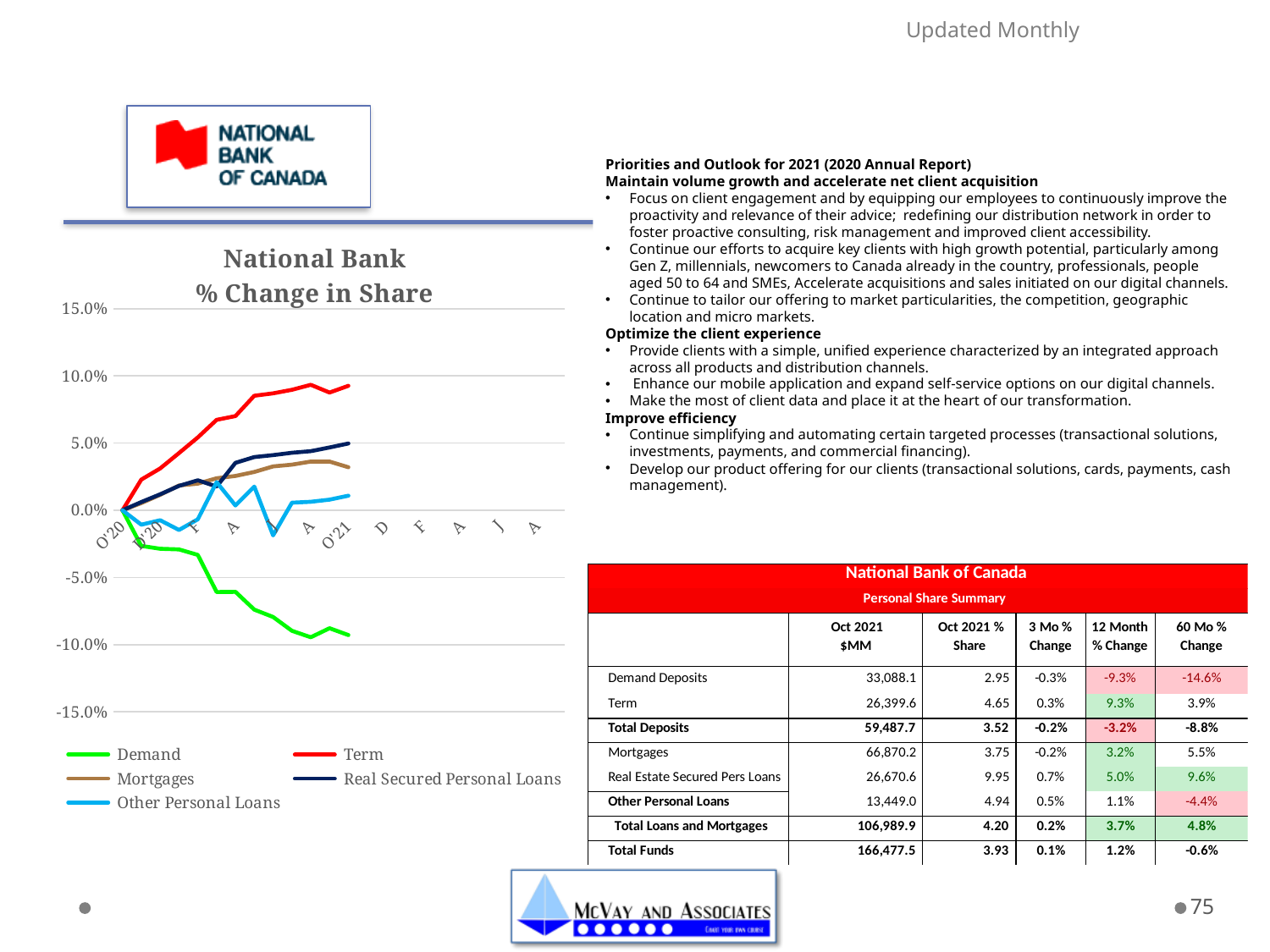
How many series does the legend of the 'National Bank % Change in Share' chart list? 5 In the 'National Bank % Change in Share' chart, is the value for Term at O'21 greater or less than 5.0%? greater What is the title of the line chart on the slide? National Bank % Change in Share In the 'National Bank % Change in Share' chart, is the value for Mortgages at O'21 greater or less than 5.0%? less In the 'National Bank % Change in Share' chart, what colour is the Demand line? green In the 'National Bank % Change in Share' chart, is the value for Demand at O'21 greater or less than -5.0%? less In the 'National Bank % Change in Share' chart, which series has the highest value at the end of the plotted period (O'21)? Term In the 'National Bank % Change in Share' chart, which series has the lowest value at the end of the plotted period (O'21)? Demand In the 'National Bank % Change in Share' chart, does the Demand series rise or fall from O'20 to O'21? fall What kind of chart is the 'National Bank % Change in Share' chart? line chart In the 'National Bank % Change in Share' chart, does the Term series rise or fall from O'20 to O'21? rise In the 'National Bank % Change in Share' chart, which is larger at O'21: Mortgages or Other Personal Loans? Mortgages